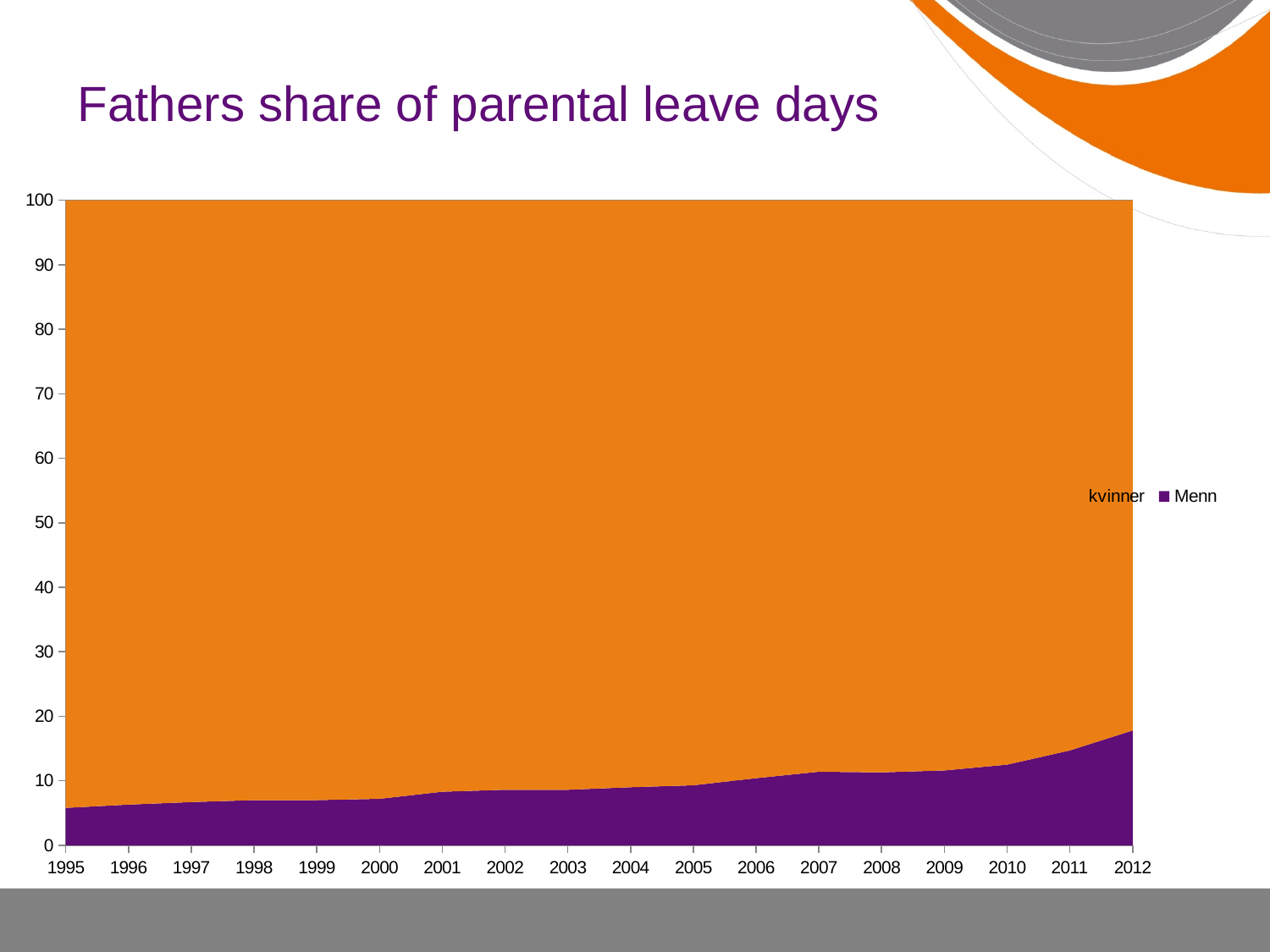
Is the Menn value for 2012 greater or less than 20? less How many years are shown on the x axis? 18 In which year is the Menn share lowest? 1995 How many series does the legend list? 2 Does the Menn share rise or fall from 1995 to 2012? rise What is the first year shown on the x axis? 1995 In which year is the Menn share highest? 2012 Is the Menn value for 1995 greater or less than 10? less What kind of chart is shown on the slide? area chart What is the last year shown on the x axis? 2012 What is the title of the chart? Fathers share of parental leave days Which series are listed in the legend? kvinner and Menn